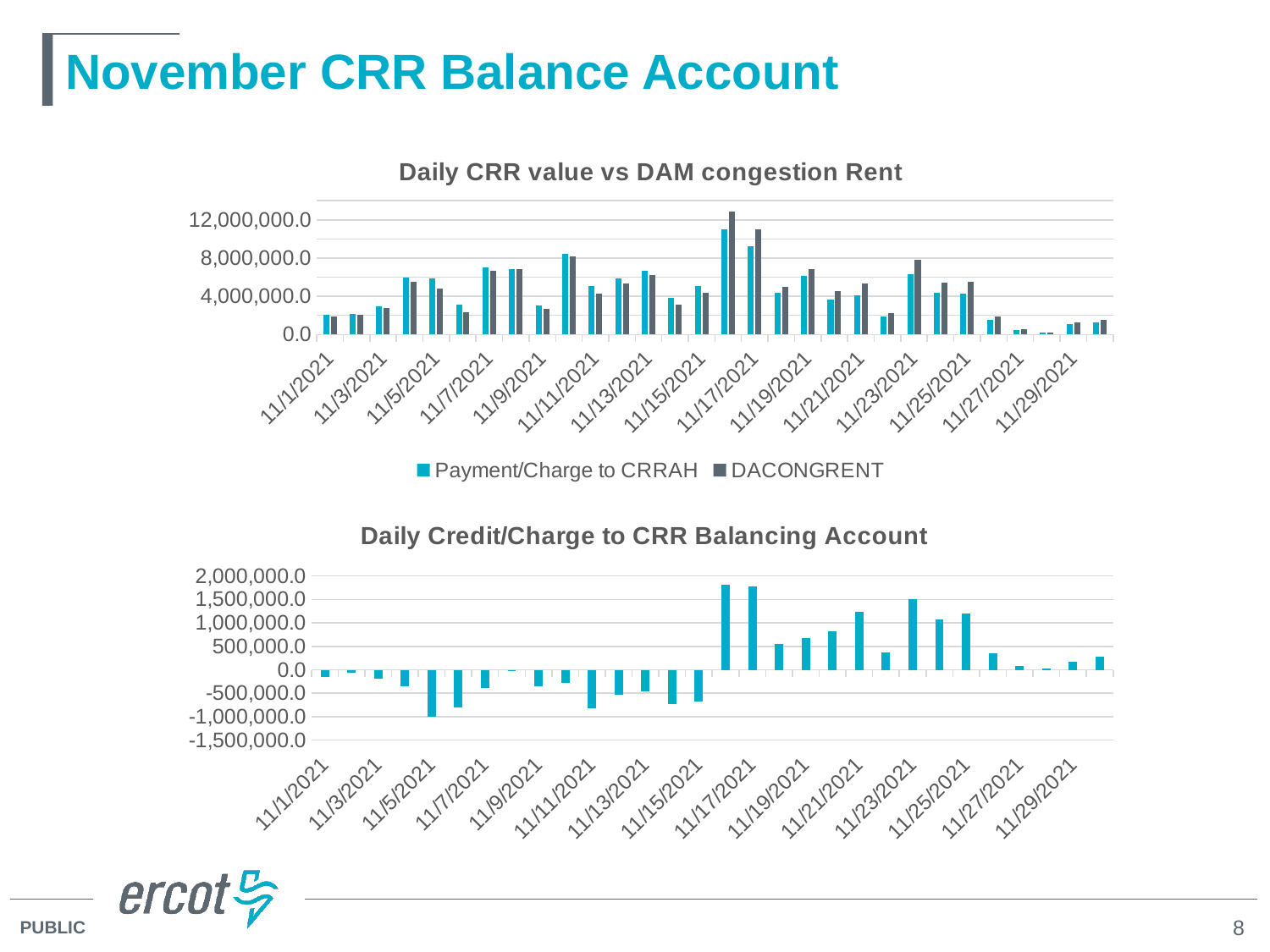
In the top chart, 'Daily CRR value vs DAM congestion Rent', how many series does the legend list? 2 How many dates are labeled on the x axis of the bottom chart, 'Daily Credit/Charge to CRR Balancing Account'? 15 In the top chart, 'Daily CRR value vs DAM congestion Rent', what are the two series named in the legend? Payment/Charge to CRRAH and DACONGRENT In the top chart, 'Daily CRR value vs DAM congestion Rent', is the DACONGRENT value on 11/17/2021 greater or less than 12,000,000.0? less In the top chart, 'Daily CRR value vs DAM congestion Rent', on which date is the DACONGRENT value highest? 11/16/2021 In the bottom chart, 'Daily Credit/Charge to CRR Balancing Account', is the value on 11/5/2021 greater or less than -500,000.0? less What kind of chart is the bottom chart, 'Daily Credit/Charge to CRR Balancing Account'? bar chart In the bottom chart, 'Daily Credit/Charge to CRR Balancing Account', is the value on 11/17/2021 greater or less than 1,500,000.0? greater In the bottom chart, 'Daily Credit/Charge to CRR Balancing Account', on which date is the value lowest? 11/5/2021 In the bottom chart, 'Daily Credit/Charge to CRR Balancing Account', are the values for the first half of November (11/1 to 11/15) mostly negative or positive? negative